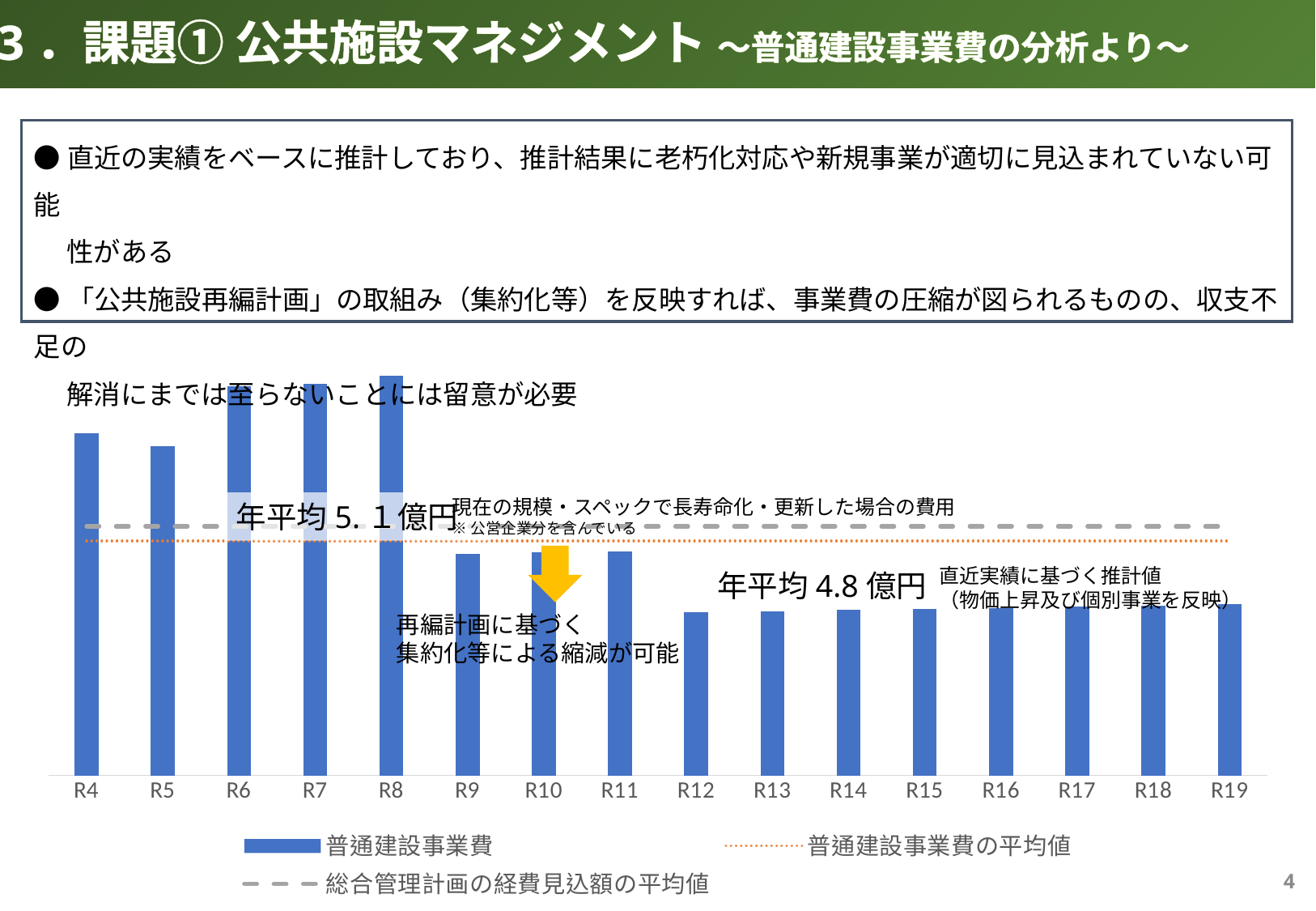
How many categories (fiscal years) are shown on the x axis of the chart? 16 Which bar is taller, R4 or R5? R4 Do the bar values generally rise or fall from R4 to R19? fall What kind of chart is shown on the slide? bar chart Which bar is taller, R8 or R12? R8 Which bar is taller, R11 or R13? R11 What is the first category on the x axis of the chart? R4 How many entries does the chart's legend list? 3 Which fiscal year has the highest bar in the chart? R8 What legend entry is represented by the blue bars? 普通建設事業費